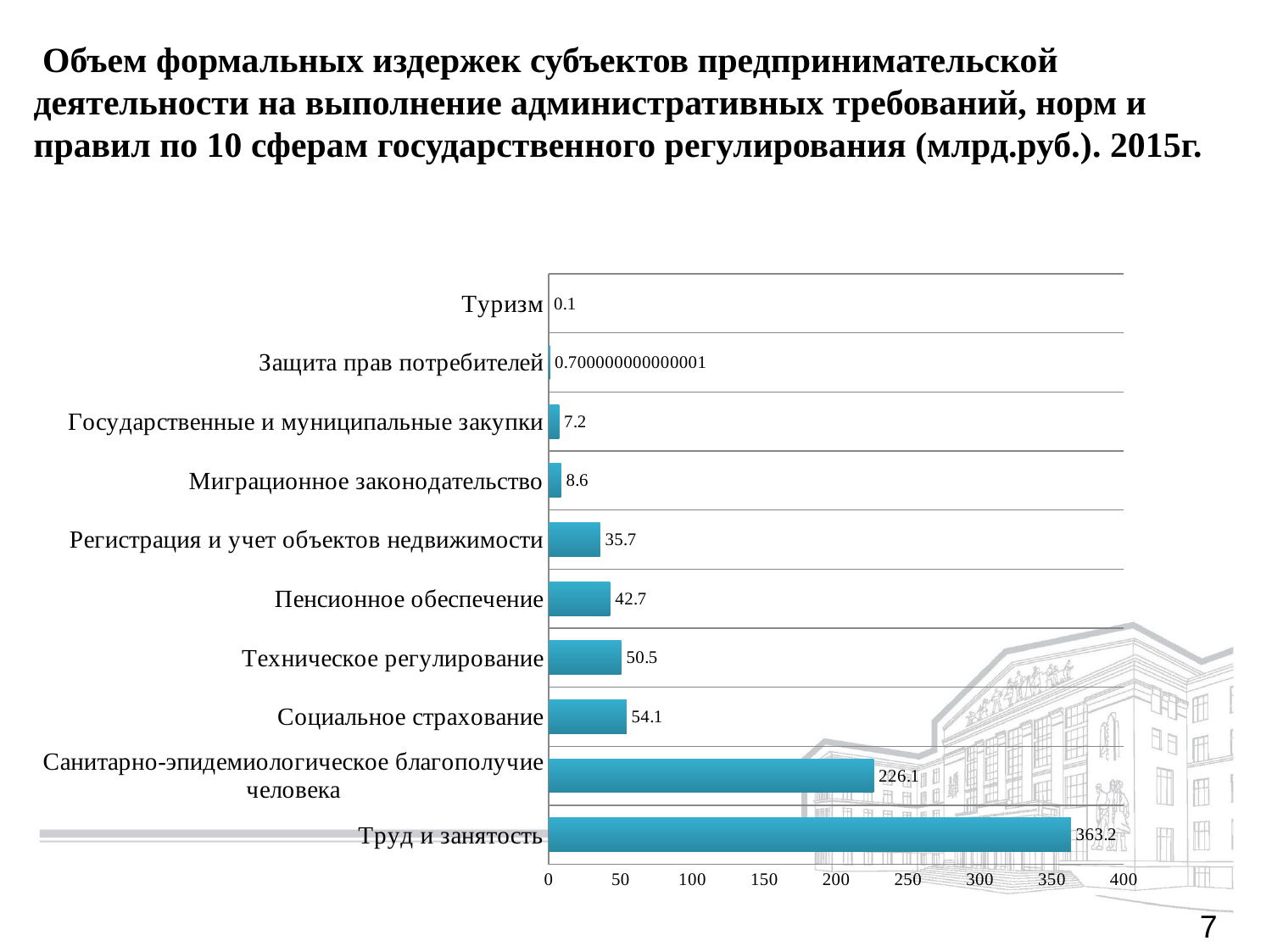
What kind of chart is shown on the slide? bar chart What is the value for Санитарно-эпидемиологическое благополучие человека? 226.1 What is the value for Миграционное законодательство? 8.6 Which category has the highest value? Труд и занятость What is the value for Труд и занятость? 363.2 What is the difference between the values for Труд и занятость and Санитарно-эпидемиологическое благополучие человека? 137.1 How many categories are shown in the chart? 10 What is the value for Пенсионное обеспечение? 42.7 Is the value for Санитарно-эпидемиологическое благополучие человека greater or less than 200? greater Which category has the lowest value? Туризм Which is larger, the value for Регистрация и учет объектов недвижимости or the value for Пенсионное обеспечение? Пенсионное обеспечение What is the difference between the values for Социальное страхование and Техническое регулирование? 3.6